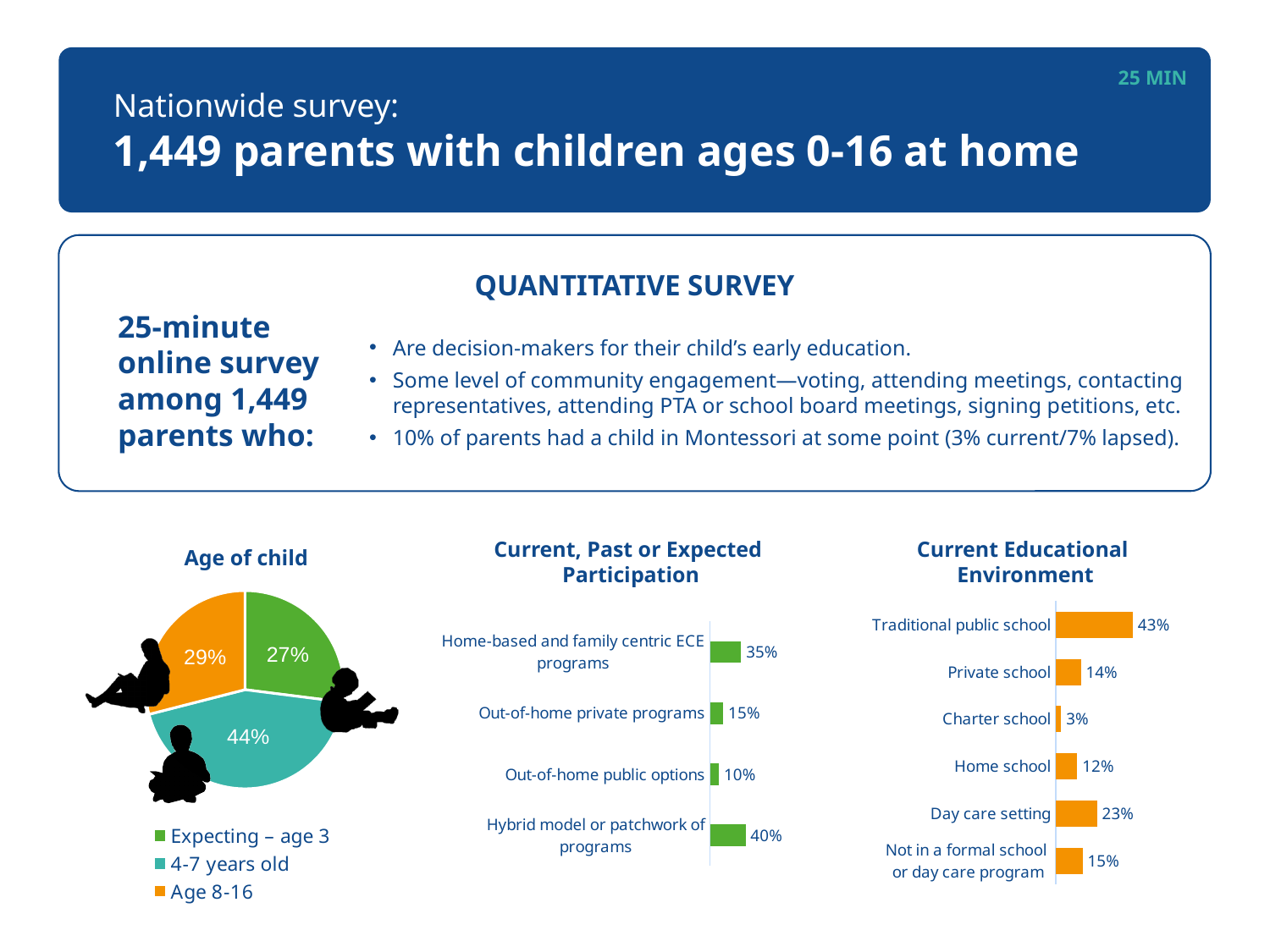
What kind of chart is the 'Age of child' chart? Pie chart In the 'Current Educational Environment' chart, which is larger: Private school or Home school? Private school In the 'Current, Past or Expected Participation' chart, what is the value for Out-of-home private programs? 15% How many categories are shown in the 'Current Educational Environment' chart? 6 In the 'Age of child' chart, which age group has the smallest share? Expecting – age 3 In the 'Current, Past or Expected Participation' chart, which category has the highest value? Hybrid model or patchwork of programs In the 'Age of child' chart, what share of children are 4-7 years old? 44% How many categories does the legend of the 'Age of child' chart list? 3 In the 'Current Educational Environment' chart, what is the value for Day care setting? 23% What kind of chart is the 'Current, Past or Expected Participation' chart? Bar chart In the 'Current Educational Environment' chart, which category has the lowest value? Charter school In the 'Current, Past or Expected Participation' chart, what is the difference between Hybrid model or patchwork of programs and Out-of-home public options? 30%